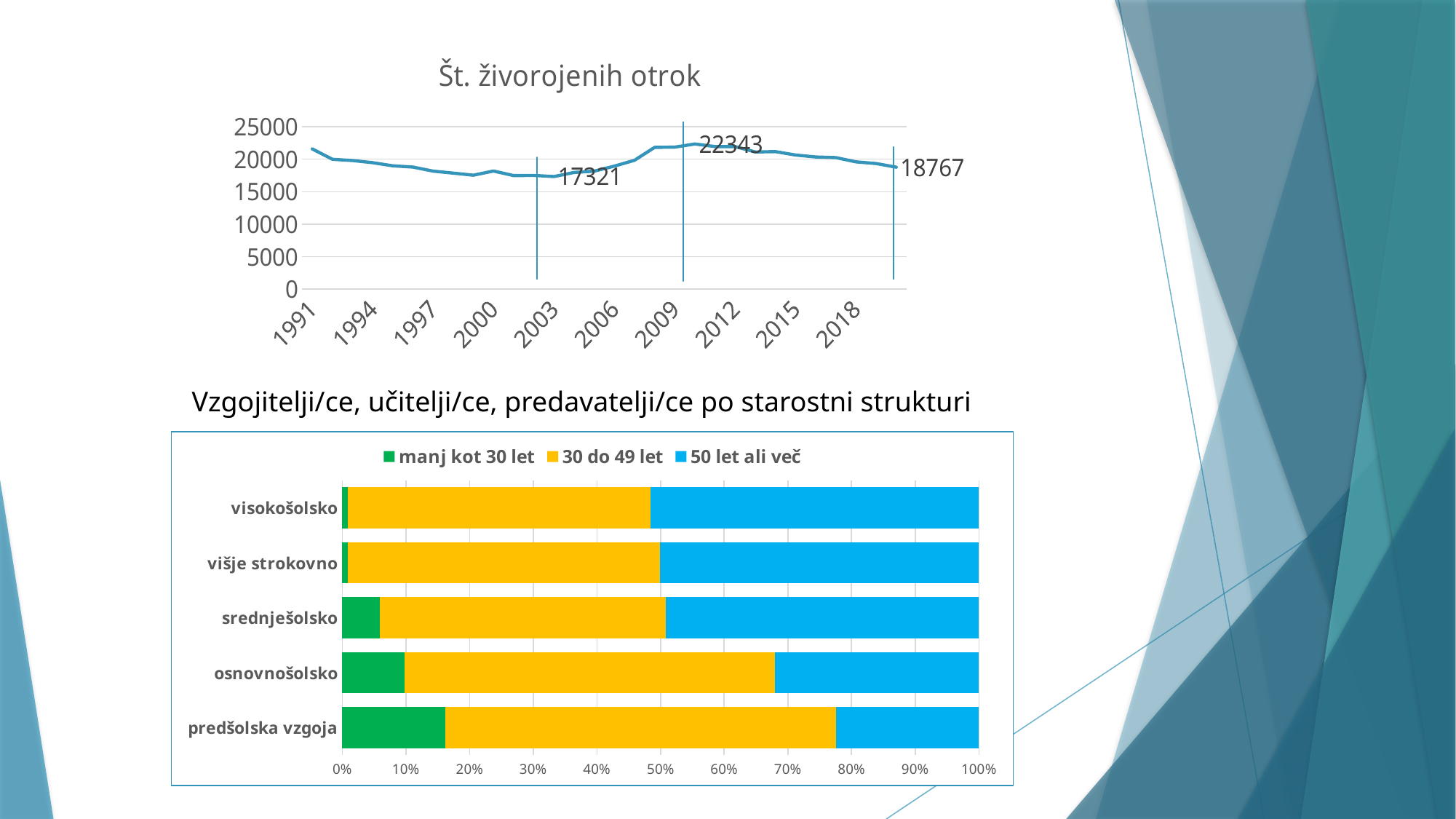
In the top chart 'Št. živorojenih otrok', what is the difference between the labelled values 22343 and 17321? 5022 In the top chart 'Št. živorojenih otrok', is the value for 1991 greater or less than 20000? greater What kind of chart is the bottom chart 'Vzgojitelji/ce, učitelji/ce, predavatelji/ce po starostni strukturi'? bar chart In the top chart 'Št. živorojenih otrok', does the line rise or fall between 1991 and 2000? fall In the top chart 'Št. živorojenih otrok', which labelled value is larger, 17321 or 18767? 18767 In the bottom chart, is the 'manj kot 30 let' share for predšolska vzgoja greater or less than 10%? greater In the bottom chart, which category has the largest share of 'manj kot 30 let'? predšolska vzgoja In the top chart 'Št. živorojenih otrok', what is the highest labelled value? 22343 What kind of chart is the top chart titled 'Št. živorojenih otrok'? line chart In the top chart 'Št. živorojenih otrok', what is the last labelled value at the right end of the line? 18767 In the bottom chart, how many education-level categories are shown? 5 In the bottom chart, how many series does the legend list? 3